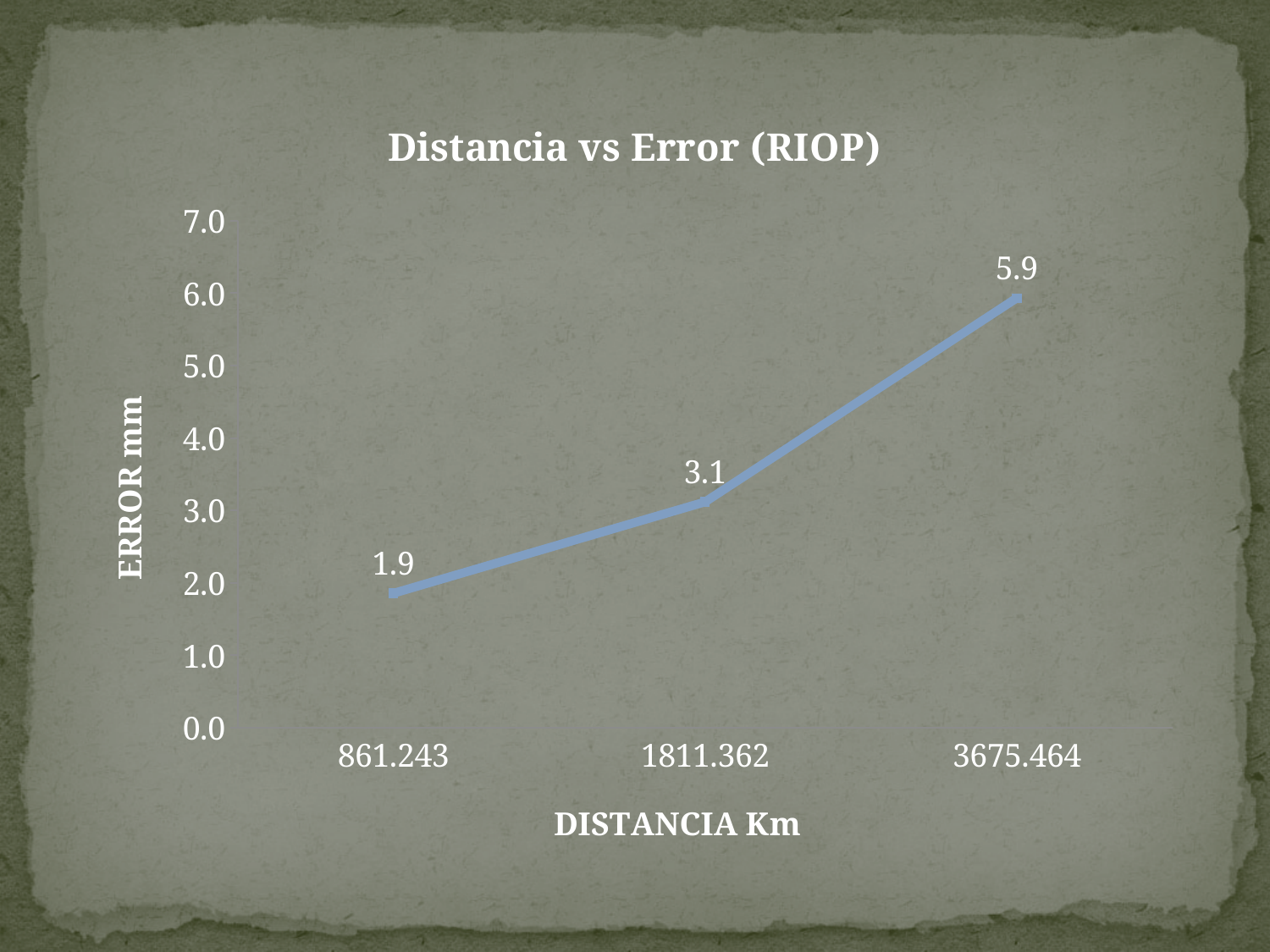
What is the difference between the error at 3675.464 km and the error at 861.243 km? 4.0 Does the error rise or fall as the distance increases? rise What is the error value at a distance of 1811.362 km? 3.1 Is the error at 3675.464 km greater or less than 5.0? greater How many data points are plotted on the chart? 3 What is the error value at a distance of 861.243 km? 1.9 At which distance is the error lowest? 861.243 At which distance is the error highest? 3675.464 What is the difference between the error at 1811.362 km and the error at 861.243 km? 1.2 What is the error value at a distance of 3675.464 km? 5.9 Which has a larger error, the distance 1811.362 km or 3675.464 km? 3675.464 What kind of chart is shown on the slide? line chart